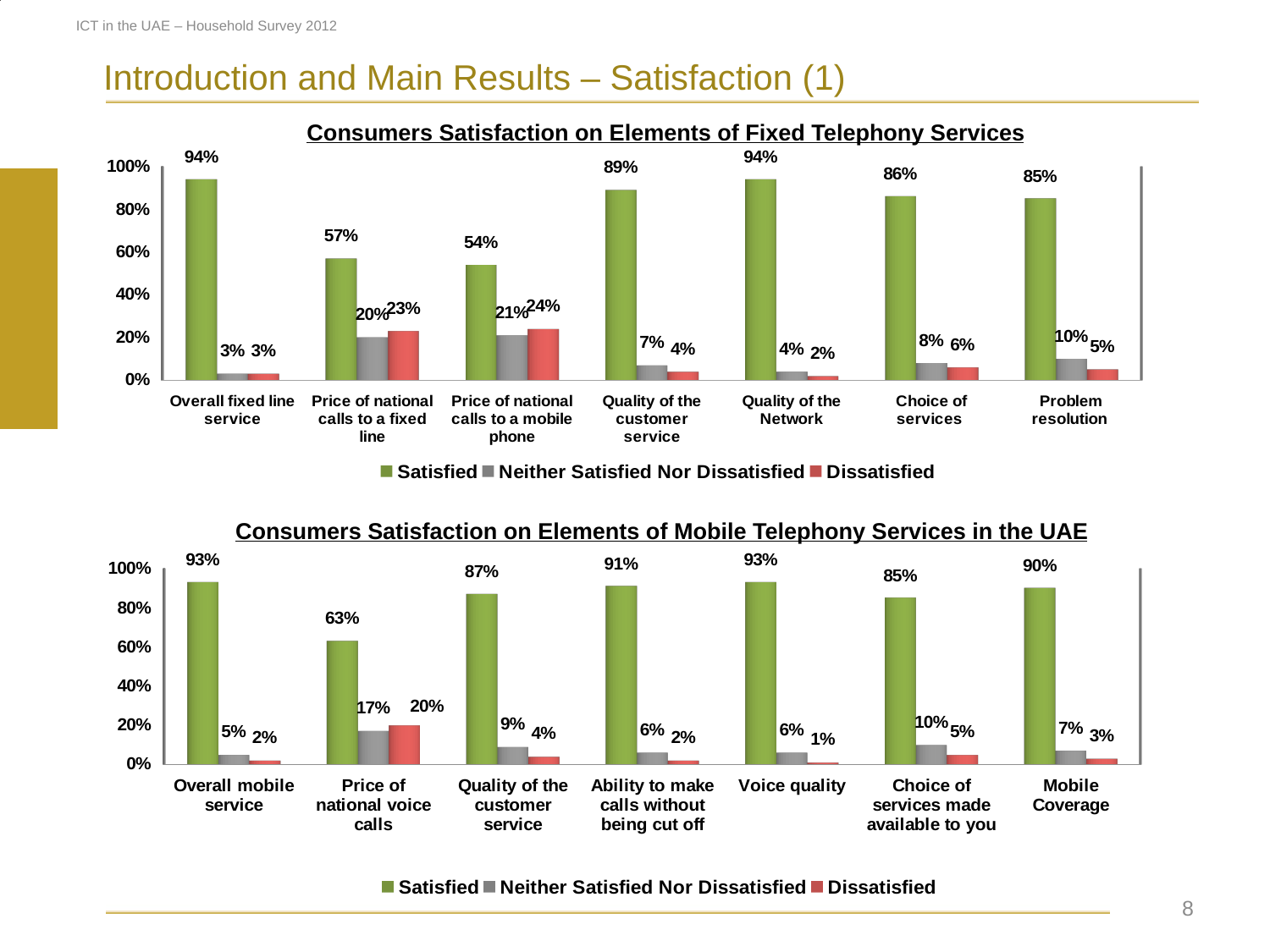
In the mobile telephony chart, what percentage of consumers are satisfied with mobile coverage? 90% In the fixed telephony chart, which element has the highest dissatisfied percentage? Price of national calls to a mobile phone In the mobile telephony chart, which element has the lowest dissatisfied percentage? Voice quality In the mobile telephony chart, which is larger: the neither satisfied nor dissatisfied value for quality of the customer service or for voice quality? Quality of the customer service In the fixed telephony chart, what percentage of consumers are satisfied with the price of national calls to a fixed line? 57% In the mobile telephony chart, which element has the lowest satisfied percentage? Price of national voice calls In the fixed telephony chart, what is the dissatisfied value for problem resolution? 5% In the fixed telephony chart, what is the difference between the satisfied percentages for quality of the customer service and choice of services? 3% In the fixed telephony chart, how many elements (categories) are shown on the x axis? 7 What type of chart is used for the fixed telephony satisfaction data? Bar chart In the fixed telephony chart, which element has the lowest satisfied percentage? Price of national calls to a mobile phone How many series does the legend of the mobile telephony chart list? 3